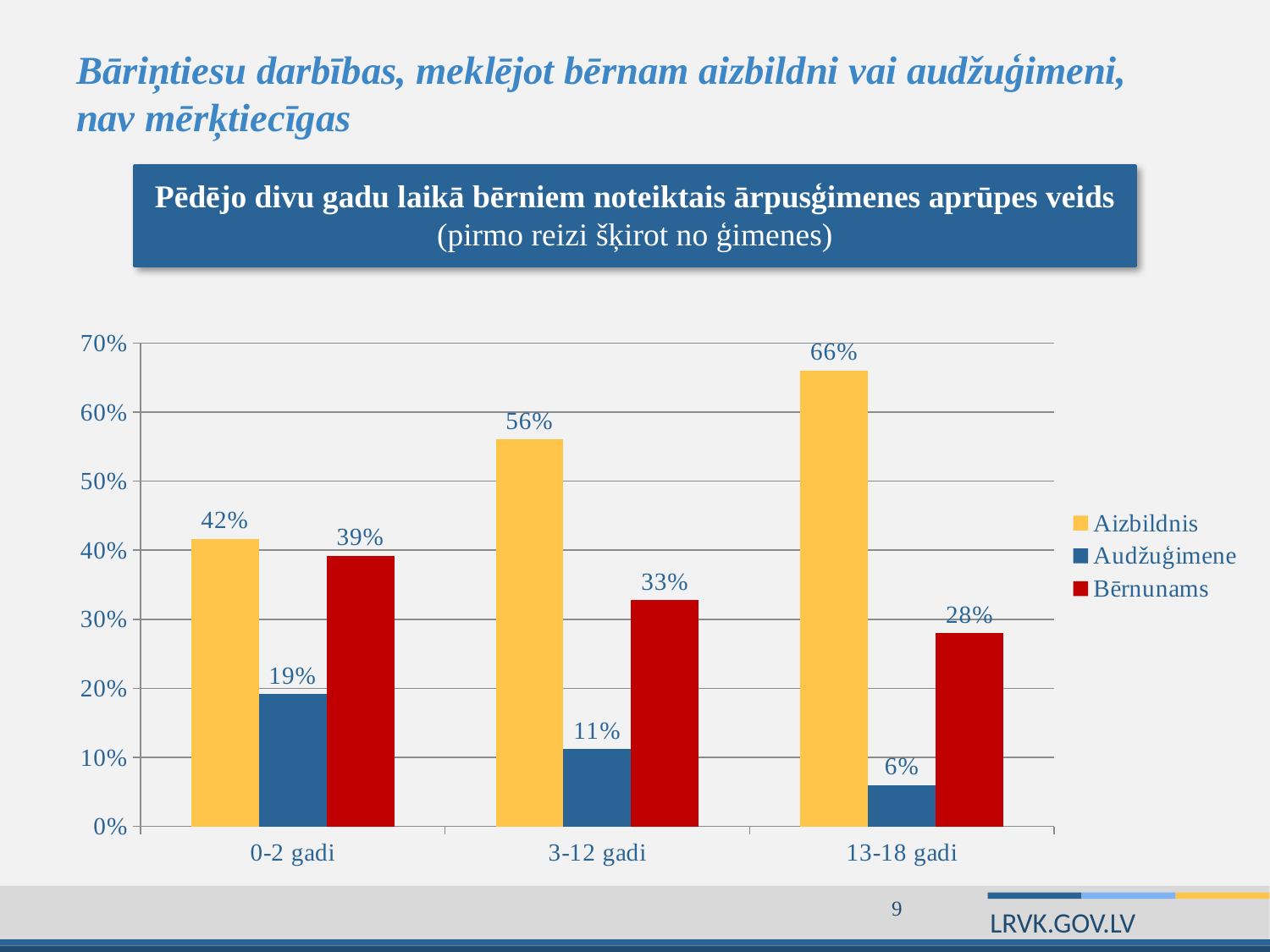
Is the value for Aizbildnis in the 13-18 gadi category greater or less than 60%? greater Which age category has the highest value for Aizbildnis? 13-18 gadi How many series does the legend list? 3 What is the value for Bērnunams in the 3-12 gadi category? 33% What is the difference between the Aizbildnis and Audžuģimene values in the 3-12 gadi category? 45% Which age category has the lowest value for Bērnunams? 13-18 gadi Which is larger in the 0-2 gadi category: Audžuģimene or Bērnunams? Bērnunams What kind of chart is shown on the slide? bar chart What is the value for Audžuģimene in the 13-18 gadi category? 6% What is the value for Aizbildnis in the 0-2 gadi category? 42% How many age categories are shown on the x axis? 3 Do the Audžuģimene values rise or fall from 0-2 gadi to 13-18 gadi? fall